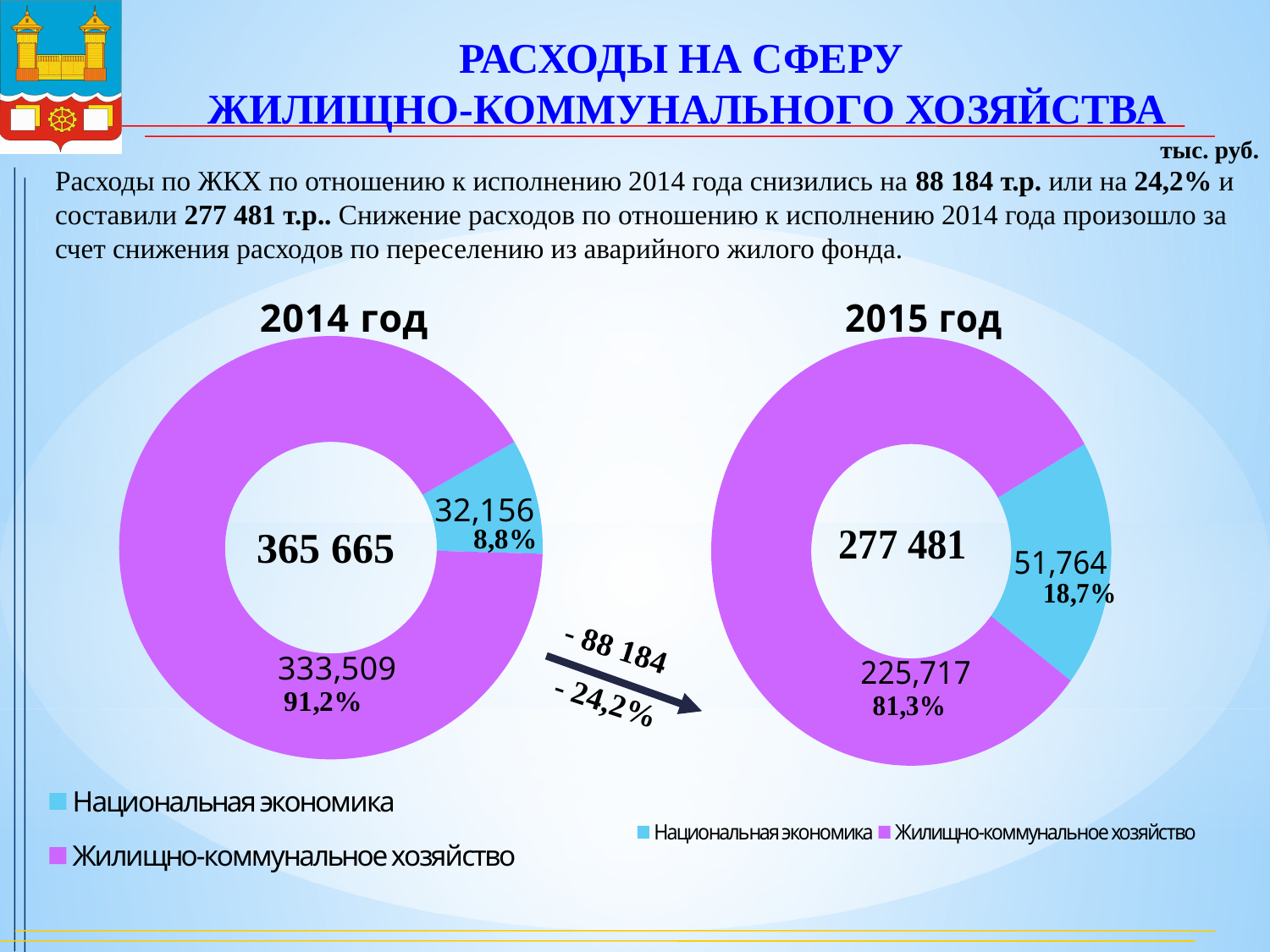
In the "2014 год" chart, what is the value for Жилищно-коммунальное хозяйство? 333,509 What type of chart is the "2014 год" chart? Doughnut chart What is the total shown in the centre of the "2014 год" chart? 365 665 In the "2014 год" chart, what share of the total does Жилищно-коммунальное хозяйство represent? 91,2% In the "2014 год" chart, which category is the largest? Жилищно-коммунальное хозяйство In the "2014 год" chart, what is the value for Национальная экономика? 32,156 How many categories does the legend of the "2015 год" chart list? 2 In the "2015 год" chart, which category is the smallest? Национальная экономика What is the total shown in the centre of the "2015 год" chart? 277 481 In the "2015 год" chart, what share of the total does Национальная экономика represent? 18,7% In the "2015 год" chart, what is the value for Национальная экономика? 51,764 In the "2015 год" chart, what is the value for Жилищно-коммунальное хозяйство? 225,717